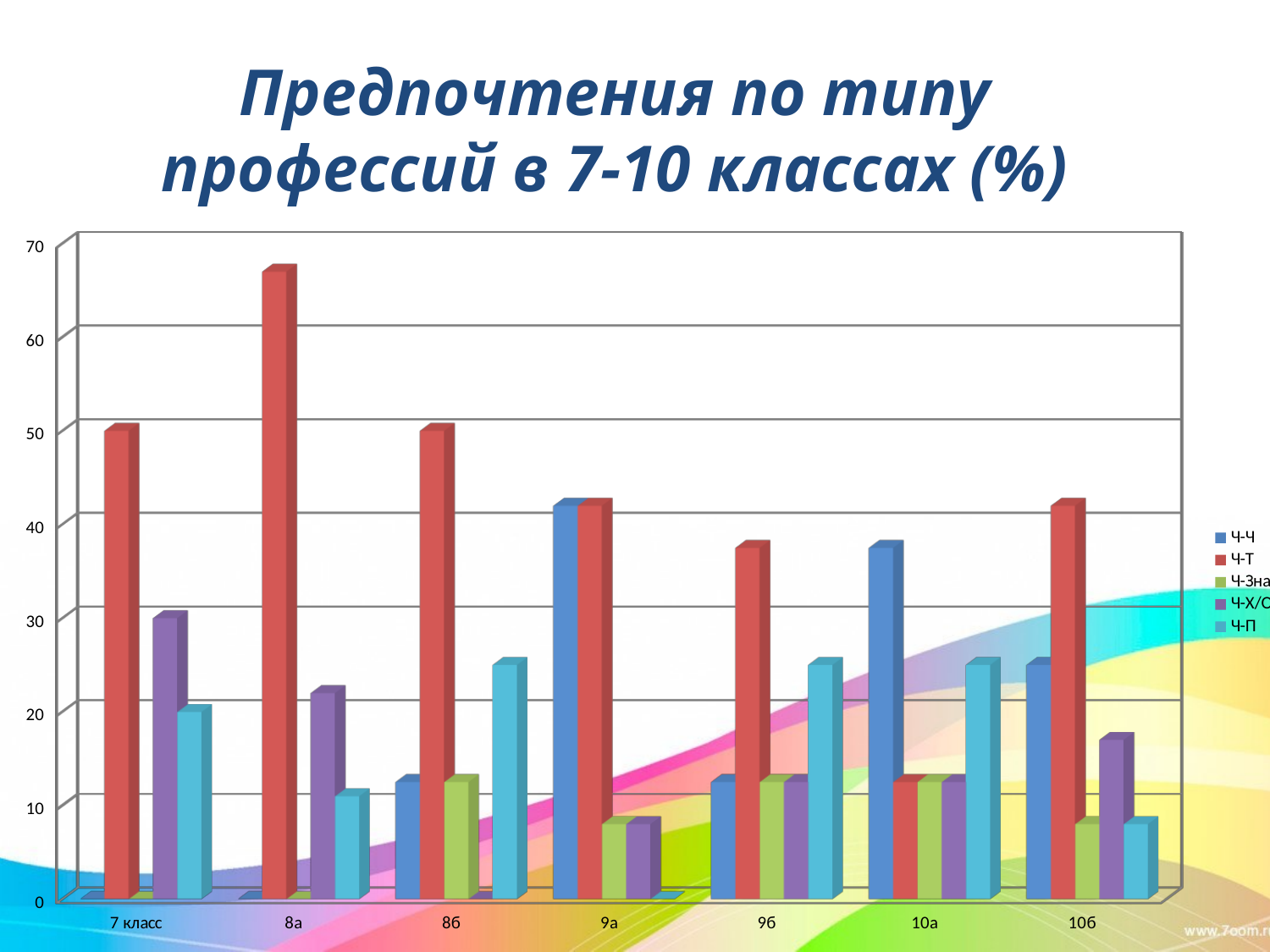
What is the first series listed in the legend? Ч-Ч Which class has the lowest value for the Ч-Т series? 10а Is the Ч-Ч value for 10а greater or less than 30? greater For 10б, which is larger: the Ч-Т value or the Ч-Ч value? Ч-Т How many classes (categories) are shown along the x axis? 7 For 9б, which is larger: the Ч-Т value or the Ч-Ч value? Ч-Т Is the Ч-П value for 8а greater or less than 20? less Which class has the highest value for the Ч-Ч series? 9а How many series does the legend list? 5 Which class has the highest value for the Ч-Т series? 8а Is the Ч-Т value for 8а greater or less than 60? greater What kind of chart is shown on the slide? bar chart